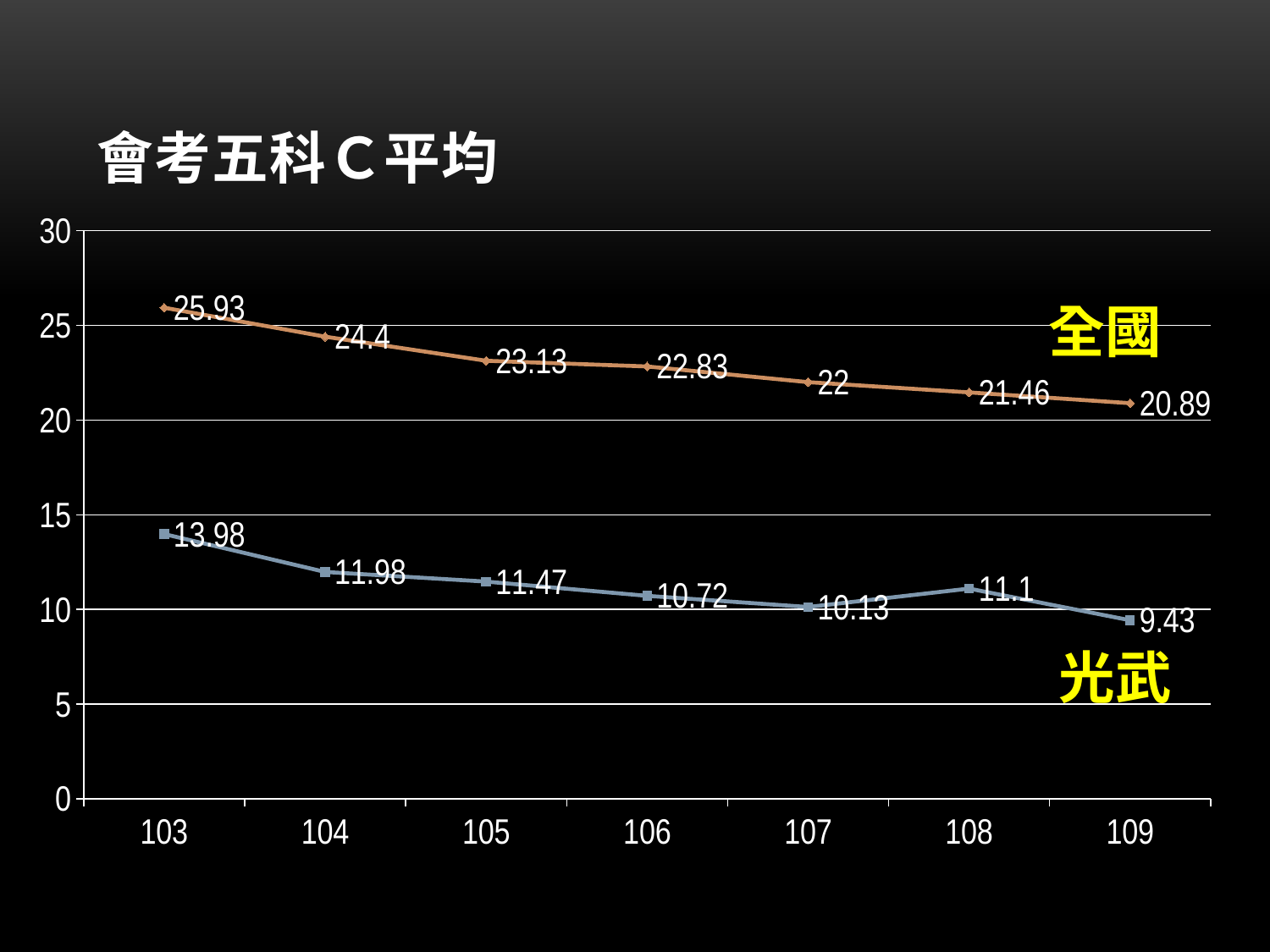
What is the value for 全國 in 103? 25.93 In which year is the 全國 value highest? 103 What is the value for 全國 in 107? 22 What is the value for 光武 in 109? 9.43 What is the difference between the 全國 and 光武 values in 109? 11.46 Which is larger in 106, the 全國 value or the 光武 value? 全國 What kind of chart is this? line chart What is the value for 光武 in 108? 11.1 How many years are shown on the x axis? 7 In which year is the 光武 value lowest? 109 How many series are plotted on the chart? 2 Does the 全國 line rise or fall from 103 to 109? fall